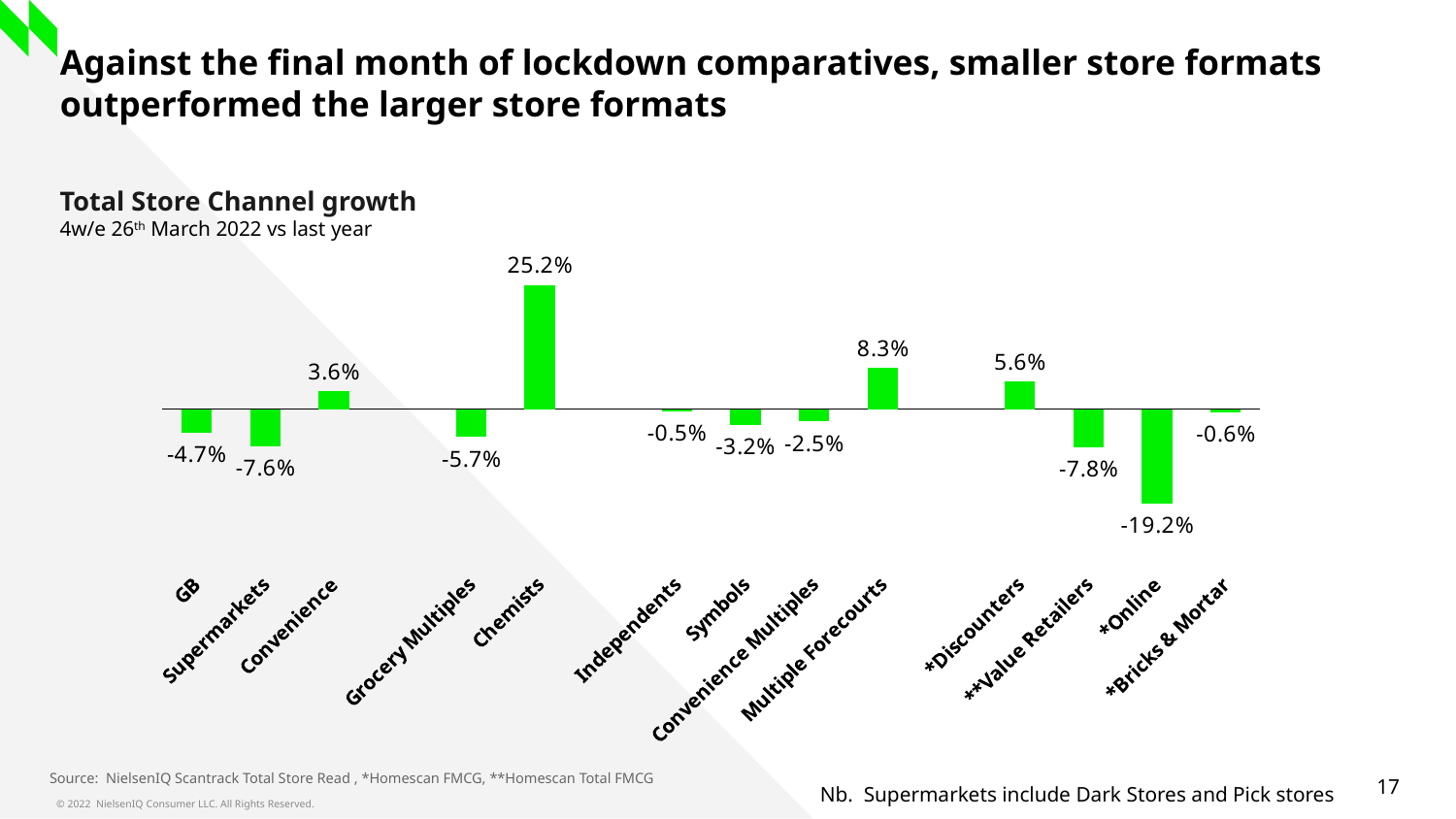
What is the title of the chart? Total Store Channel growth What is the difference between the growth values for Chemists and Multiple Forecourts? 16.9 percentage points What is the growth value for Independents? -0.5% What is the growth value for Chemists? 25.2% How many channels are shown in the chart? 13 What is the growth value for Supermarkets? -7.6% Which has the higher growth value, Convenience or *Discounters? *Discounters What is the growth value for *Online? -19.2% What is the growth value for Multiple Forecourts? 8.3% Which channel has the lowest growth value? *Online Which channel has the highest growth value? Chemists What kind of chart is shown on the slide? Bar chart